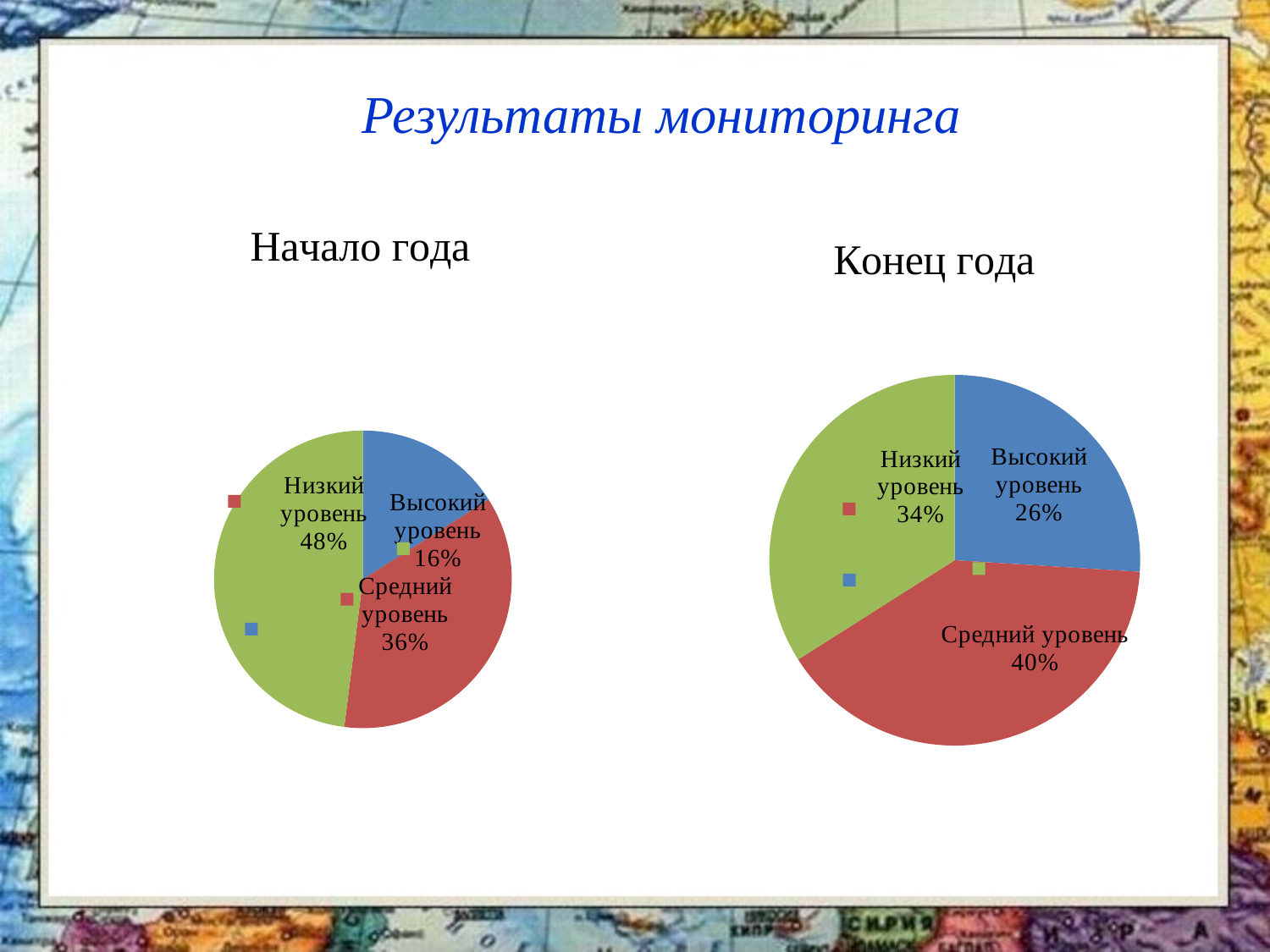
How many slices does the "Конец года" pie chart have? 3 In the "Конец года" chart, what is the value for "Средний уровень"? 40% In the "Начало года" chart, what is the difference between "Низкий уровень" and "Средний уровень"? 12% In the "Конец года" chart, which category has the largest share? Средний уровень What is the title of the slide containing the two charts? Результаты мониторинга In the "Конец года" chart, which category has the smallest share? Высокий уровень In the "Начало года" chart, which category has the largest share? Низкий уровень Which is larger: "Высокий уровень" in the "Начало года" chart or "Высокий уровень" in the "Конец года" chart? Конец года In the "Начало года" chart, what is the value for "Низкий уровень"? 48% In the "Начало года" chart, what is the value for "Высокий уровень"? 16% In the "Конец года" chart, what is the value for "Высокий уровень"? 26% What type of chart is used for "Начало года"? Pie chart